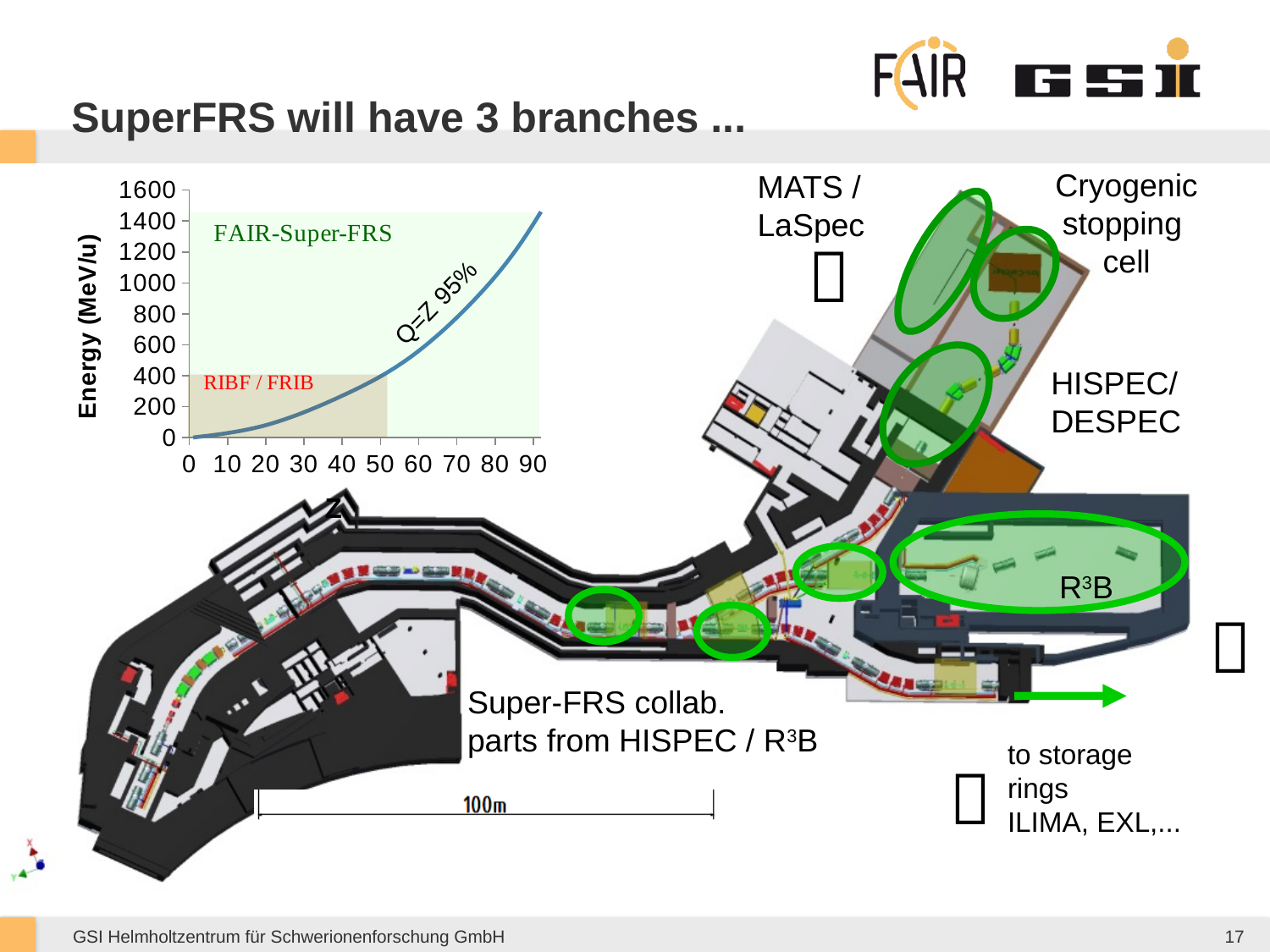
What is the label of the x axis of the chart? Z What is the highest tick value shown on the y axis of the chart? 1600 What is the label of the y axis of the chart? Energy (MeV/u) What kind of chart is shown on the left of the slide? line chart Is the energy value of the curve at Z = 20 greater or less than 400 MeV/u? less Is the energy value of the curve at Z = 50 greater or less than 600 MeV/u? less Does the energy curve rise or fall as Z increases? rises Is the energy value of the curve at Z = 70 greater or less than 600 MeV/u? greater Which has the higher energy on the curve: Z = 30 or Z = 80? Z = 80